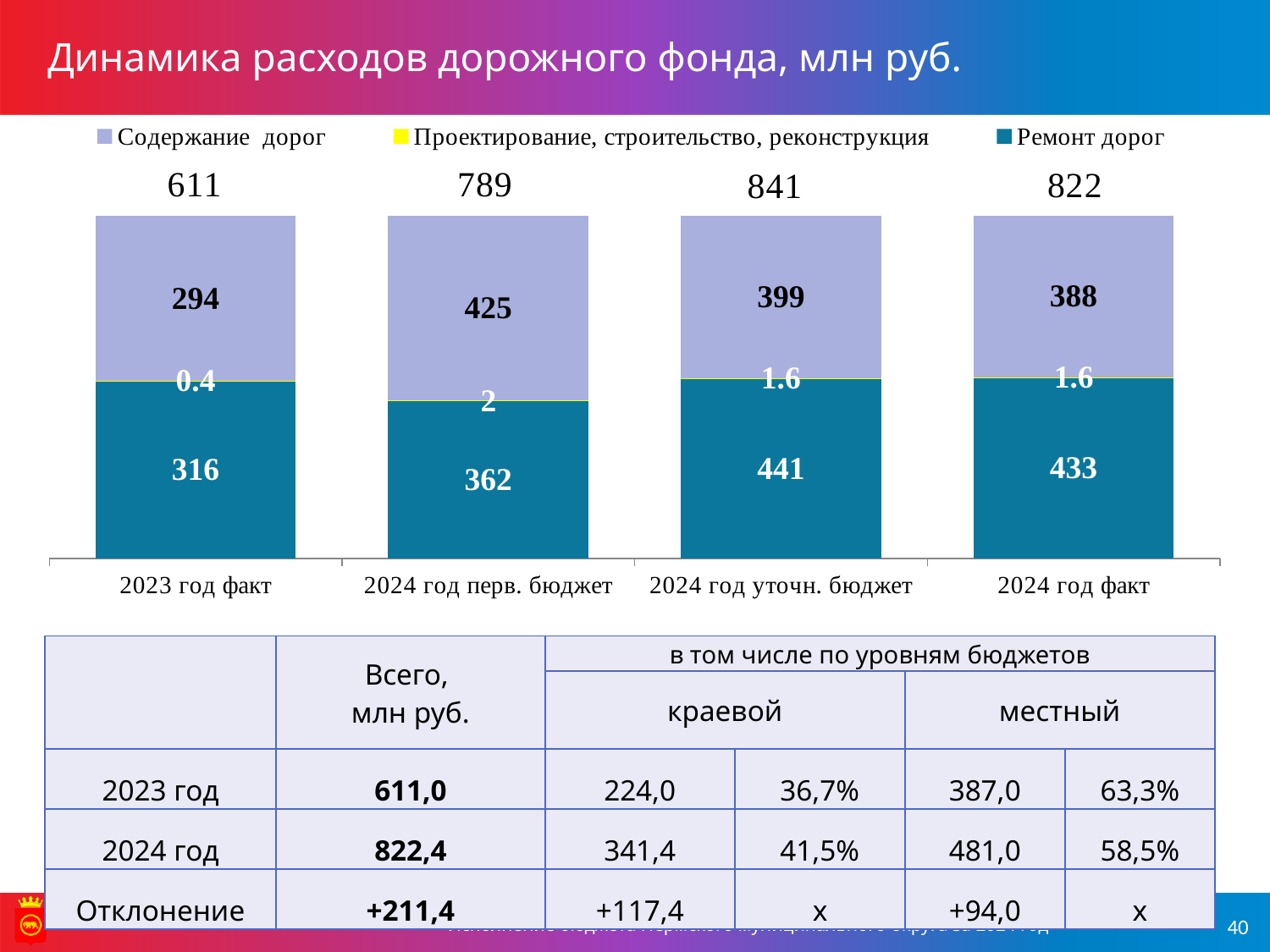
What is the value of Ремонт дорог for 2024 год уточн. бюджет? 441 Which colour represents Ремонт дорог in the chart? teal (dark blue-green) What is the total shown above the bar for 2024 год факт? 822 Which is larger: Содержание дорог for 2023 год факт or for 2024 год факт? 2024 год факт How many categories are shown along the x axis of the chart? 4 Which category has the highest total in the chart? 2024 год уточн. бюджет What is the difference between the Ремонт дорог values for 2024 год факт and 2023 год факт? 117 Which category has the lowest value for Ремонт дорог? 2023 год факт What is the value of Содержание дорог for 2024 год перв. бюджет? 425 How many series does the chart legend list? 3 What kind of chart is shown on the slide? stacked bar chart What is the value of Проектирование, строительство, реконструкция for 2023 год факт? 0.4